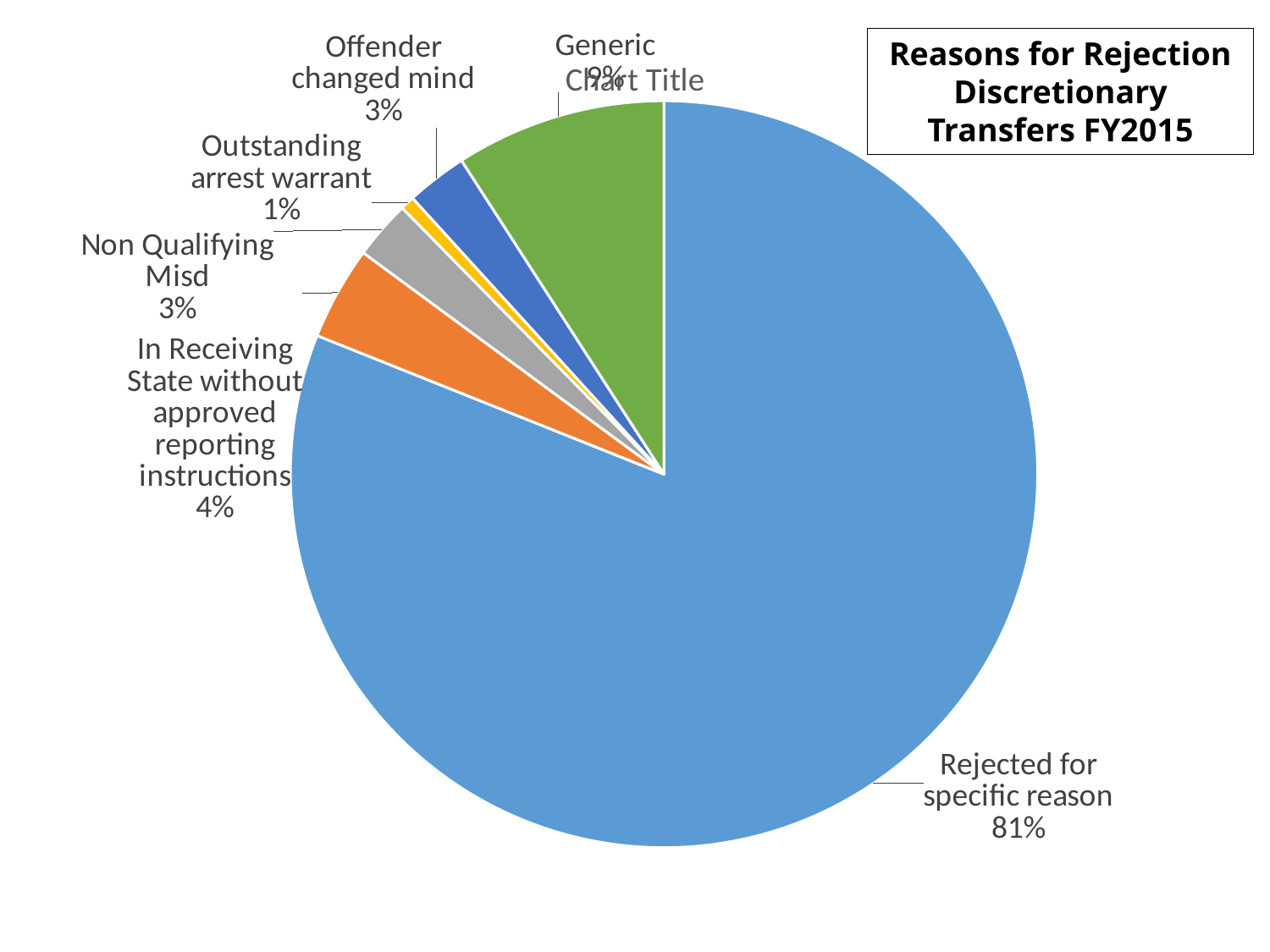
What percentage is shown for "Outstanding arrest warrant"? 1% What percentage is shown for "In Receiving State without approved reporting instructions"? 4% What percentage is shown for "Offender changed mind"? 3% Which reason accounts for the smallest share of the pie? Outstanding arrest warrant How many slices does the pie chart have? 6 What percentage is shown for "Non Qualifying Misd"? 3% Which reason accounts for the largest share of the pie? Rejected for specific reason What is the title shown in the text box at the top right of the slide? Reasons for Rejection Discretionary Transfers FY2015 What is the difference in percentage points between "Rejected for specific reason" and "In Receiving State without approved reporting instructions"? 77 Which is larger: the "Generic" slice or the "In Receiving State without approved reporting instructions" slice? Generic What type of chart is shown on the slide? Pie chart What share of the pie is labelled "Rejected for specific reason"? 81%